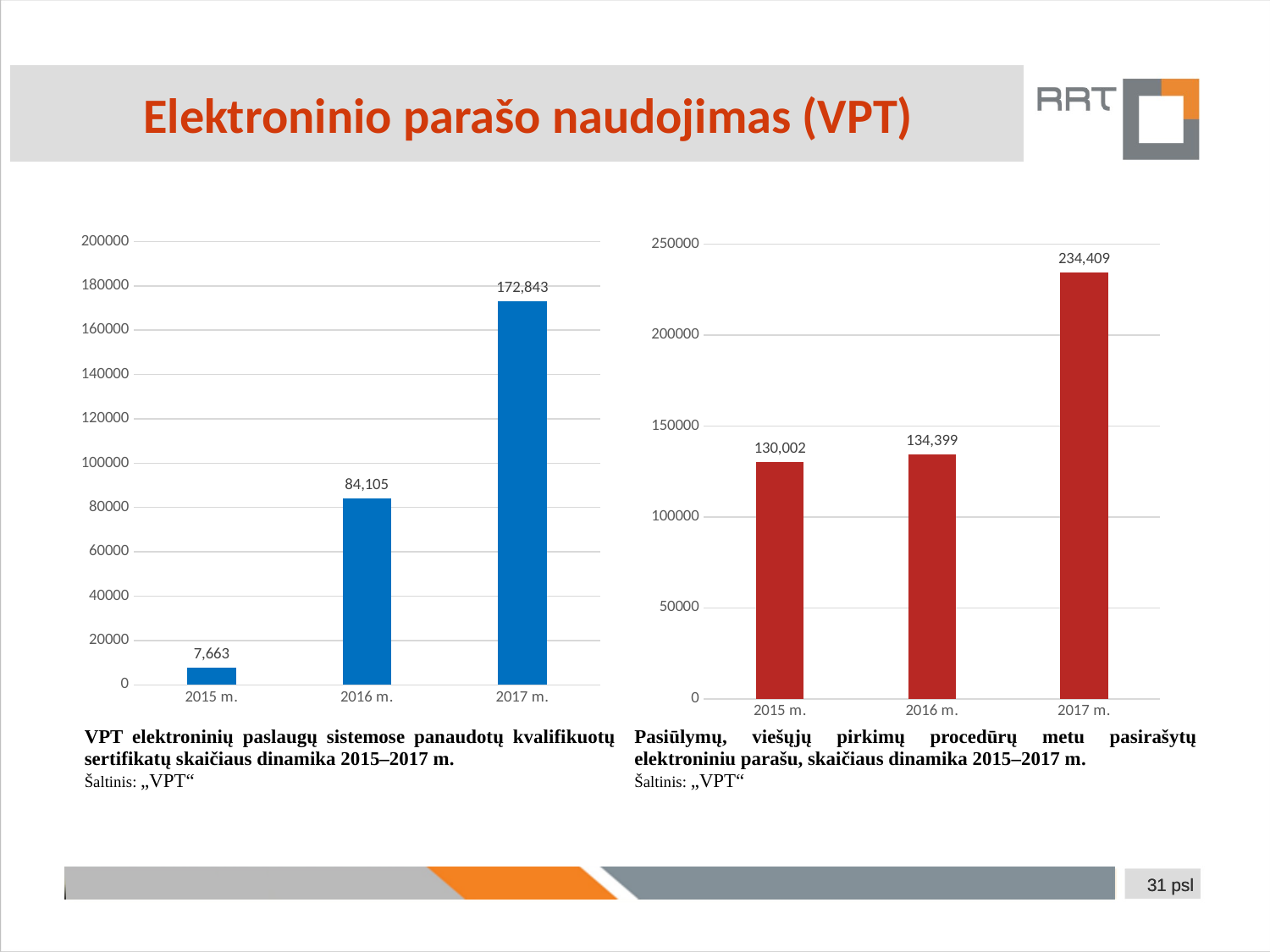
How many bars does the left chart have? 3 In the right chart, what is the value for 2017 m.? 234,409 In the left chart, do the values rise or fall from 2015 m. to 2017 m.? rise In the left chart, what is the value for 2015 m.? 7,663 In the right chart, what is the difference between the values for 2017 m. and 2016 m.? 100,010 In the left chart, which year has the highest value? 2017 m. In the left chart, what is the difference between the values for 2017 m. and 2016 m.? 88,738 In the left chart, what is the value for 2016 m.? 84,105 In the right chart, which is larger, the value for 2016 m. or the value for 2015 m.? 2016 m. In the right chart, what is the value for 2015 m.? 130,002 What kind of chart is the right chart? bar chart In the right chart, which year has the lowest value? 2015 m.